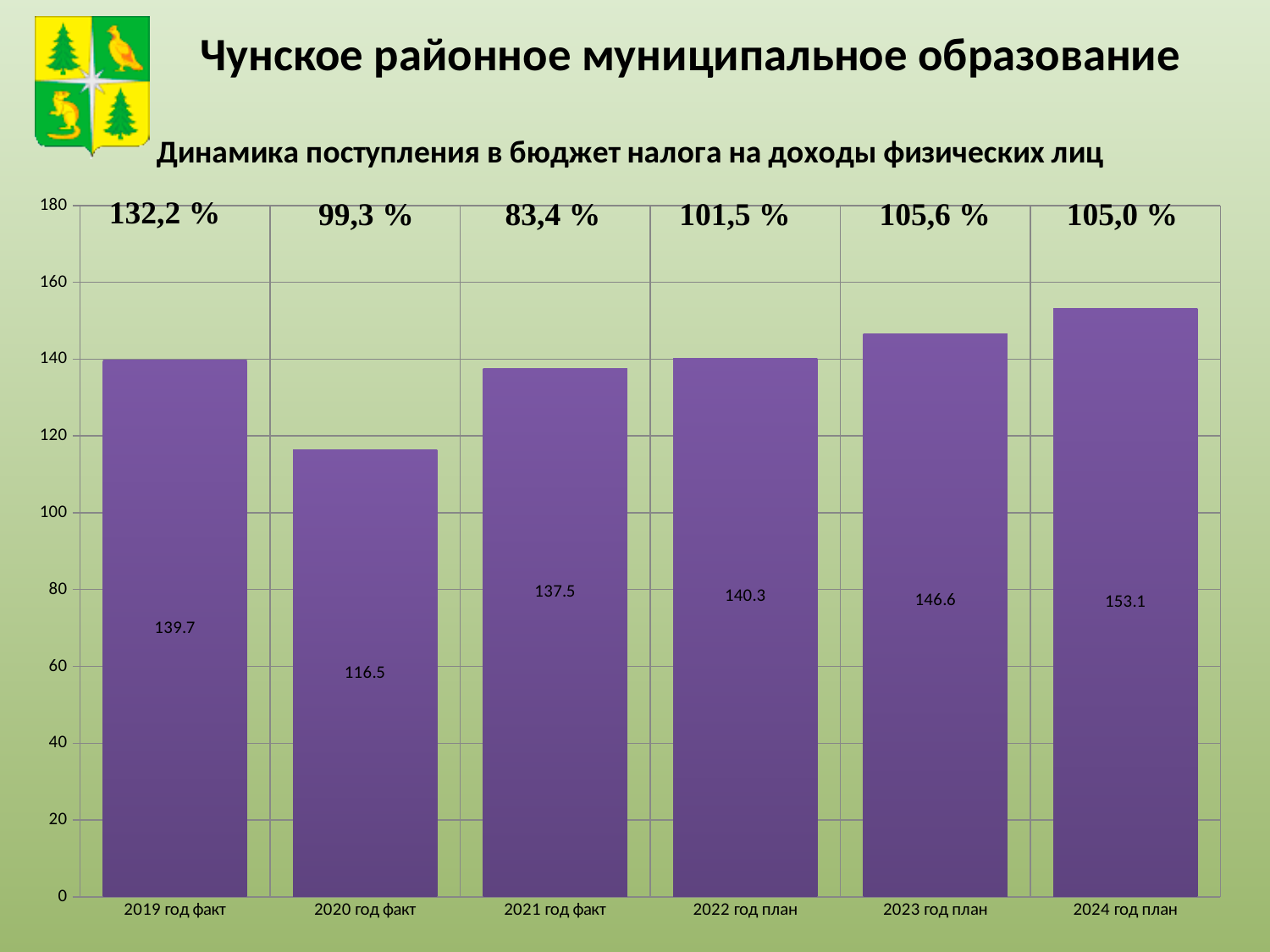
How many categories are shown on the x axis? 6 What percentage label is printed above the bar for 2021 год факт? 83,4 % Which category has the lowest value? 2020 год факт What is the value for 2019 год факт? 139.7 What is the difference between the values for 2019 год факт and 2020 год факт? 23.2 Which is larger, the value for 2021 год факт or the value for 2022 год план? 2022 год план Which category has the highest value? 2024 год план What kind of chart is shown on the slide? bar chart What is the difference between the values for 2024 год план and 2023 год план? 6.5 What is the value for 2020 год факт? 116.5 What is the value for 2024 год план? 153.1 Is the value for 2023 год план greater or less than 140? greater